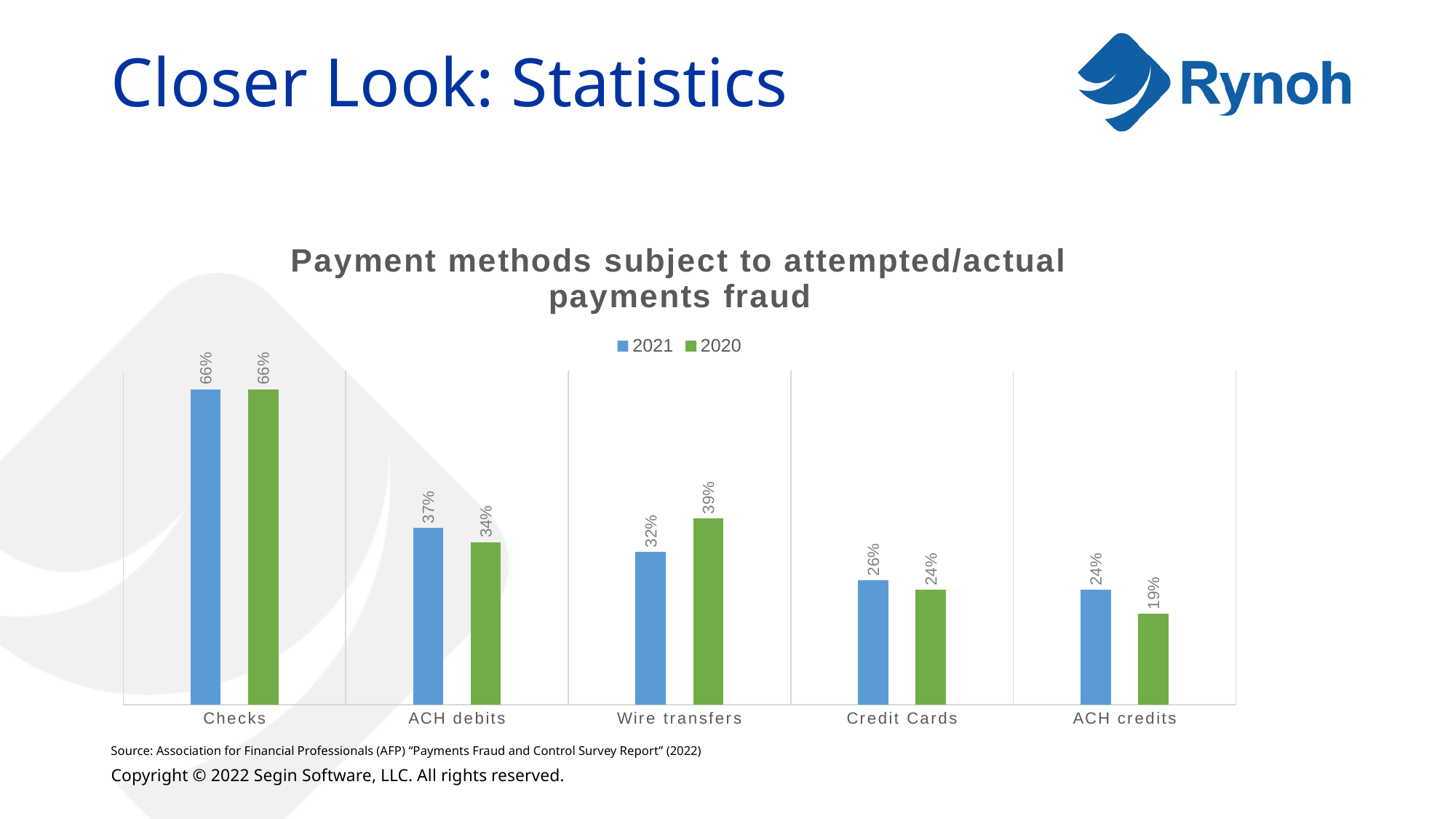
How many series does the legend list? 2 What is the title of the chart? Payment methods subject to attempted/actual payments fraud What kind of chart is shown on the slide? Bar chart What is the 2020 value for ACH credits? 19% What is the 2021 value for Credit Cards? 26% What is the difference between the 2021 and 2020 values for ACH credits? 5% Which payment method has the lowest 2020 value? ACH credits How many payment method categories are shown on the x axis? 5 Which is larger for Wire transfers, the 2021 value or the 2020 value? 2020 What is the 2021 value for Checks? 66% Which payment method has the highest 2021 value? Checks What is the 2020 value for Wire transfers? 39%